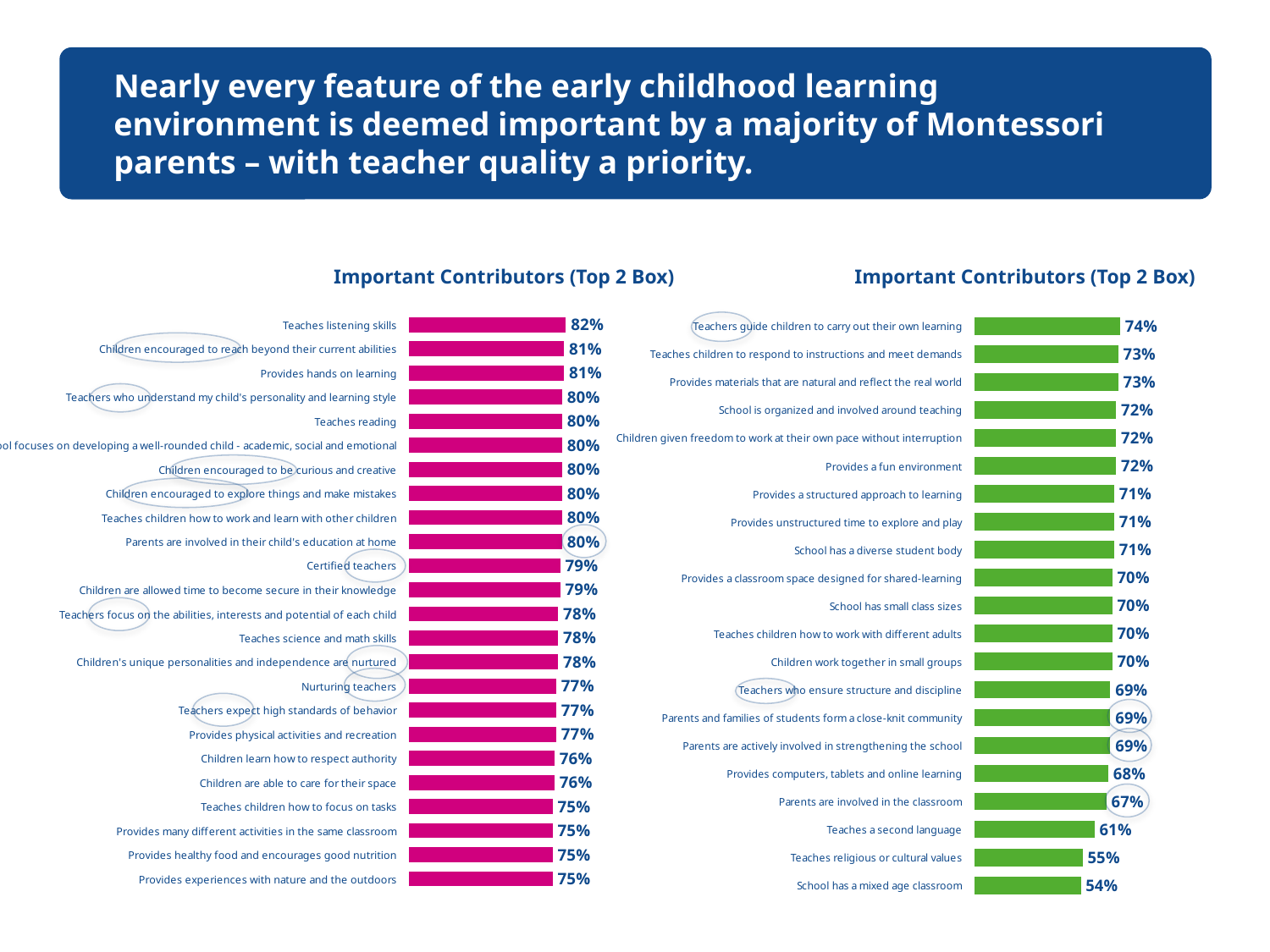
In the right chart, which category has the highest value? Teachers guide children to carry out their own learning In the right chart, which category has the lowest value? School has a mixed age classroom In the left chart, what is the value for 'Certified teachers'? 79% In the left chart, what is the value for 'Teaches listening skills'? 82% In the left chart, which category has the highest value? Teaches listening skills How many categories are shown in the right chart? 21 What type of chart is the left chart? Bar chart How many categories are shown in the left chart? 24 In the right chart, what is the difference between 'Teachers guide children to carry out their own learning' and 'School has a mixed age classroom'? 20% In the right chart, what is the value for 'Teaches a second language'? 61% In the left chart, what is the difference between 'Teaches listening skills' and 'Provides experiences with nature and the outdoors'? 7% In the right chart, which is larger: 'Provides computers, tablets and online learning' or 'Teaches religious or cultural values'? Provides computers, tablets and online learning